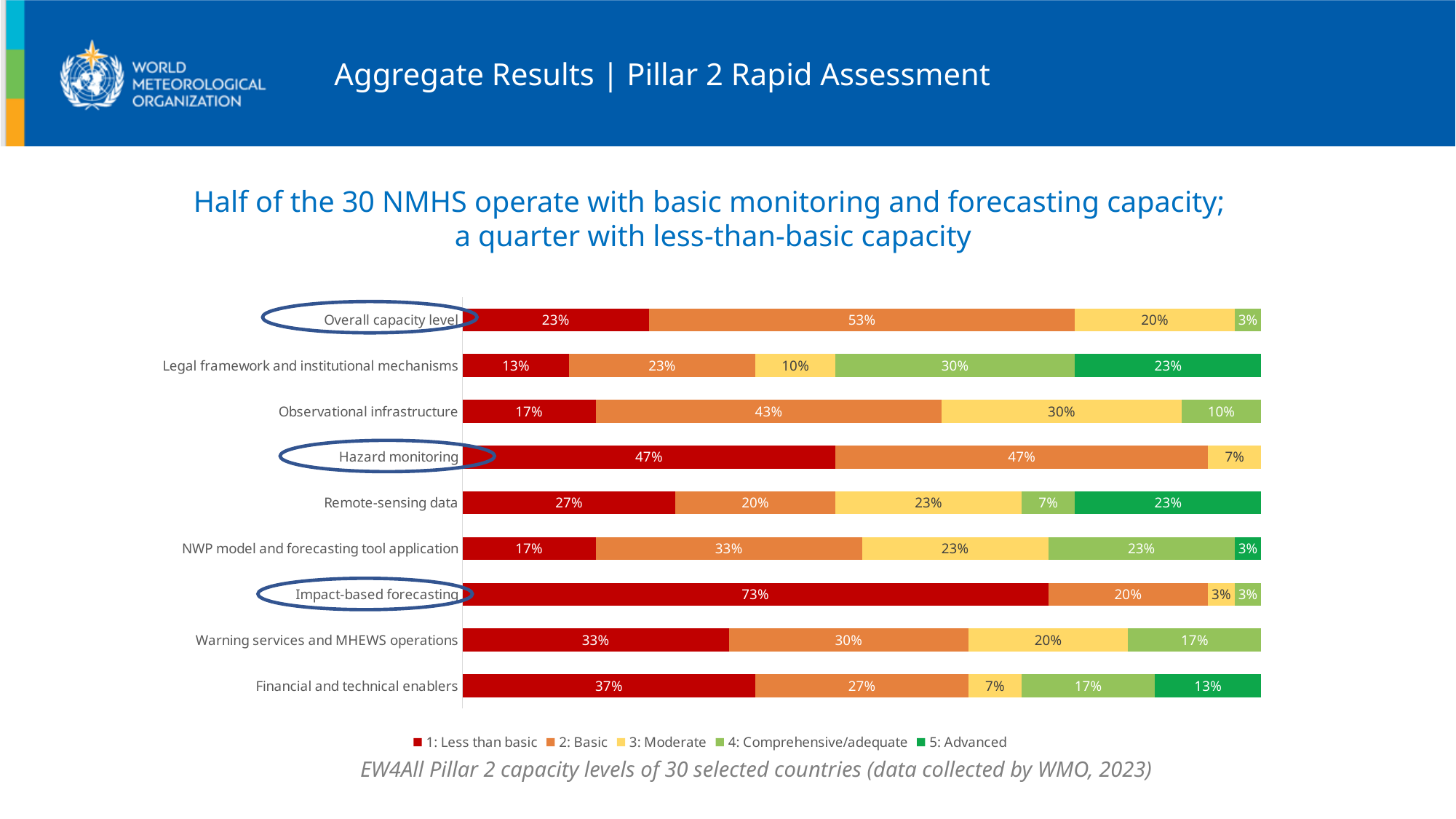
How many series does the legend list? 5 Which category has the lowest '1: Less than basic' value? Legal framework and institutional mechanisms What is the '5: Advanced' value for Financial and technical enablers? 13% What is the '1: Less than basic' value for Impact-based forecasting? 73% What is the difference between the '1: Less than basic' values for Hazard monitoring and Overall capacity level? 24% Which has a larger '2: Basic' value, Observational infrastructure or Remote-sensing data? Observational infrastructure Which legend entry is shown in dark green? 5: Advanced What is the '2: Basic' value for Overall capacity level? 53% What kind of chart is shown on the slide? Stacked bar chart What is the '4: Comprehensive/adequate' value for Legal framework and institutional mechanisms? 30% Which category has the highest '1: Less than basic' value? Impact-based forecasting How many categories are plotted on the chart? 9